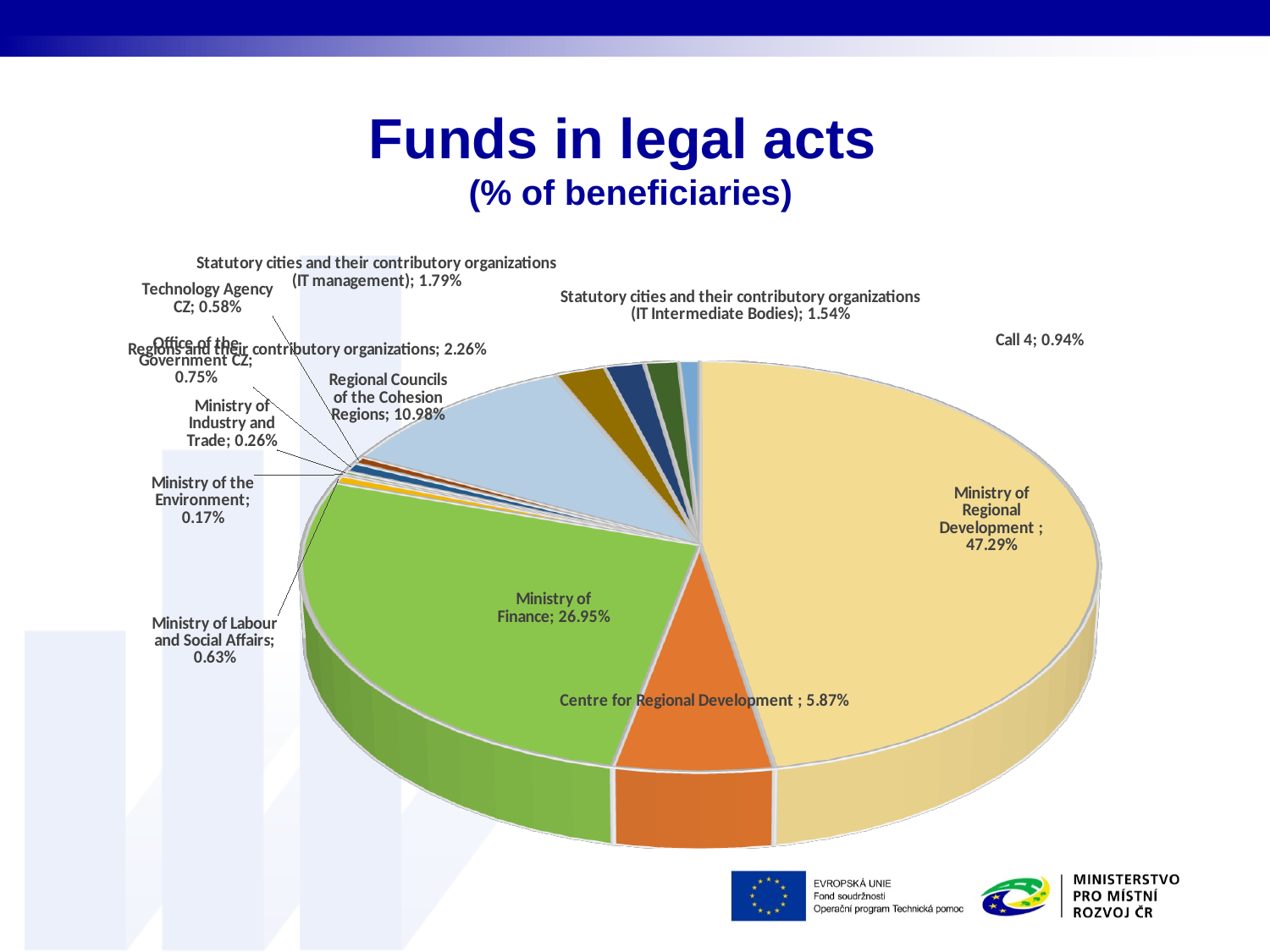
Which category has the largest slice of the pie? Ministry of Regional Development Which category has the smallest slice of the pie? Ministry of the Environment What is the value for the Regional Councils of the Cohesion Regions? 10.98% What is the title of the chart? Funds in legal acts (% of beneficiaries) What type of chart is shown on the slide? pie chart How many categories are shown in the pie chart? 13 What is the value for the Centre for Regional Development? 5.87% What is the value for Call 4? 0.94% What is the difference between the Ministry of Regional Development and the Ministry of Finance? 20.34% What is the value for the Ministry of Finance? 26.95% What share of the pie does the Ministry of Regional Development hold? 47.29% Which is larger, the Regional Councils of the Cohesion Regions or the Centre for Regional Development? Regional Councils of the Cohesion Regions